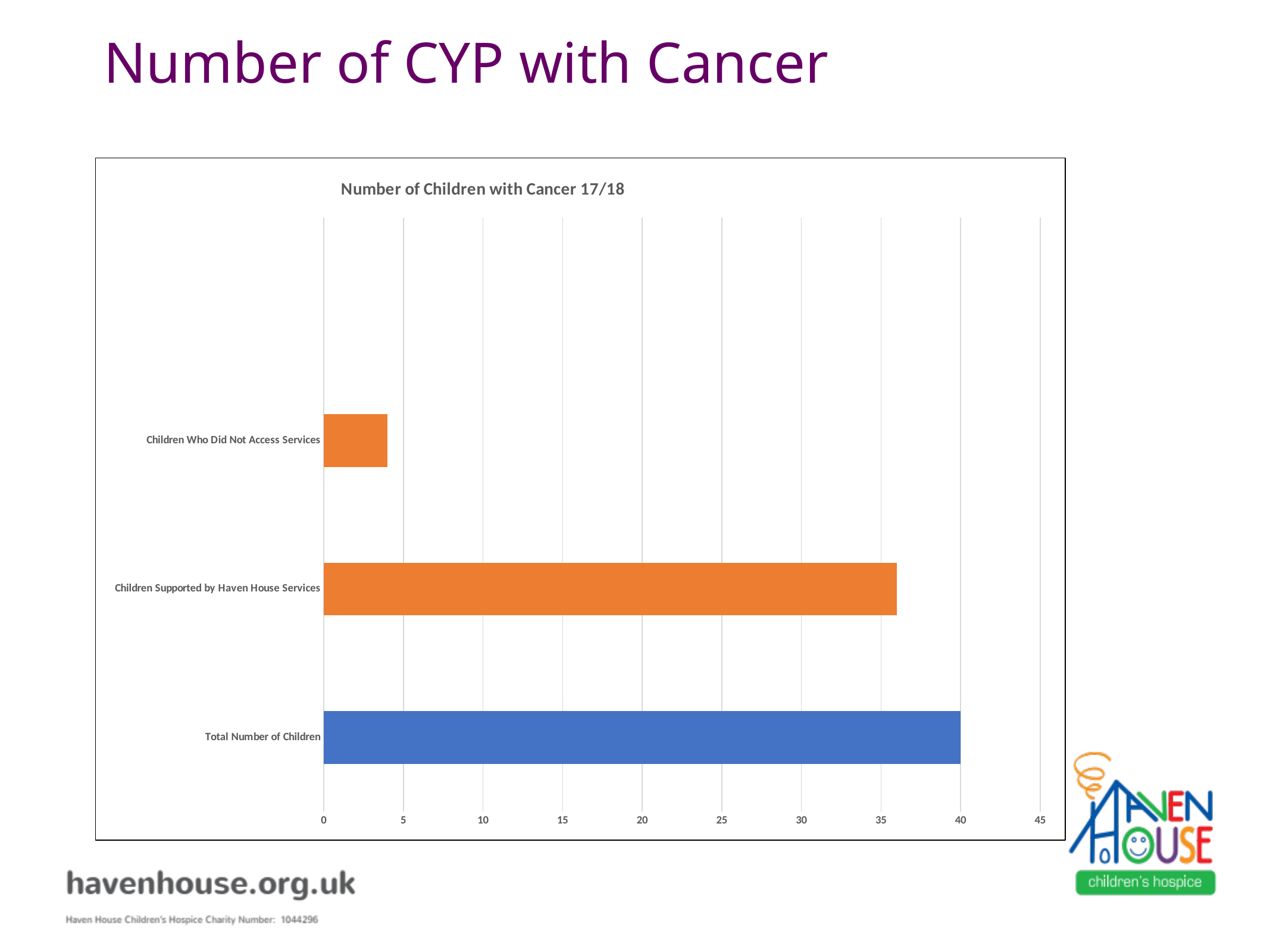
Which category has the lowest value? Children Who Did Not Access Services Is the value for Children Supported by Haven House Services greater or less than 35? greater Which category has the highest value? Total Number of Children Is the value for Children Who Did Not Access Services greater or less than 5? less What is the value for Total Number of Children? 40 What colour is the bar for Total Number of Children? Blue Is the value for Children Supported by Haven House Services greater or less than 40? less Which is larger: Total Number of Children or Children Supported by Haven House Services? Total Number of Children What type of chart is shown on the slide? Bar chart How many categories are plotted in the chart? 3 What is the title of the chart? Number of Children with Cancer 17/18 Which is larger: Children Supported by Haven House Services or Children Who Did Not Access Services? Children Supported by Haven House Services